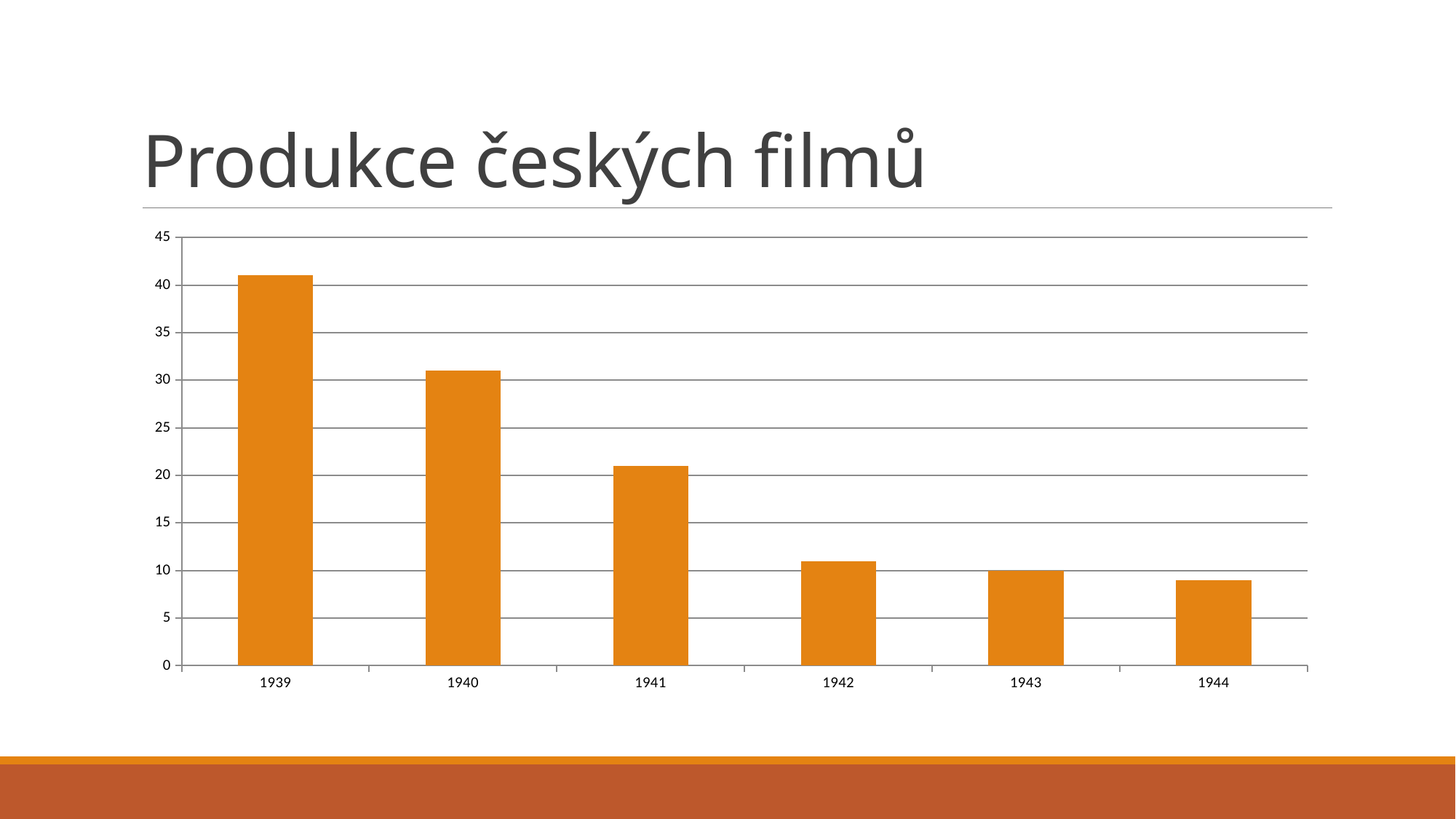
Is the value for 1942 greater or less than 15? less Which is larger, the value for 1940 or the value for 1941? 1940 What colour are the bars in the chart? orange What is the title of the chart? Produkce českých filmů Which year has the highest bar in the chart? 1939 Is the value for 1941 greater or less than 25? less What is the value for 1943? 10 What kind of chart is shown on the slide? bar chart Do the values rise or fall from 1939 to 1944? fall Is the value for 1939 greater or less than 40? greater How many years are shown on the x axis of the chart? 6